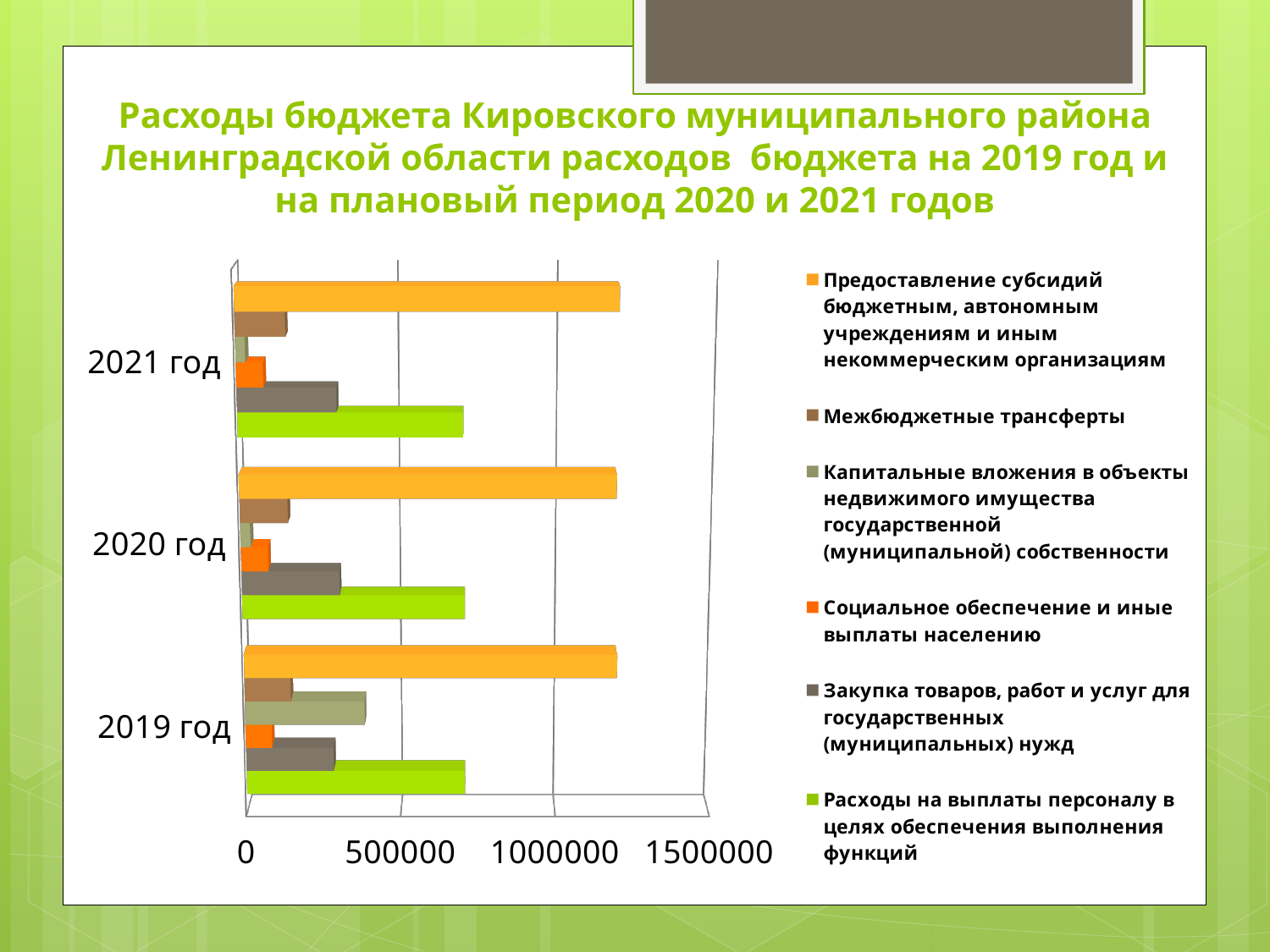
Is the value for Закупка товаров, работ и услуг in 2020 год greater or less than 500000? less In 2019 год, which is larger: Капитальные вложения or Закупка товаров, работ и услуг? Капитальные вложения Is the value for Межбюджетные трансферты in 2019 год greater or less than 500000? less What kind of chart is shown on the slide? bar chart Which series has the highest value for 2021 год? Предоставление субсидий бюджетным, автономным учреждениям и иным некоммерческим организациям Is the value for Предоставление субсидий in 2019 год greater or less than 1000000? greater How many series does the legend list? 6 What colour represents Предоставление субсидий in the legend? orange Which series has the lowest value for 2020 год? Капитальные вложения в объекты недвижимого имущества государственной (муниципальной) собственности How many year categories are shown on the chart? 3 Does the value for Капитальные вложения rise or fall from 2019 год to 2021 год? fall